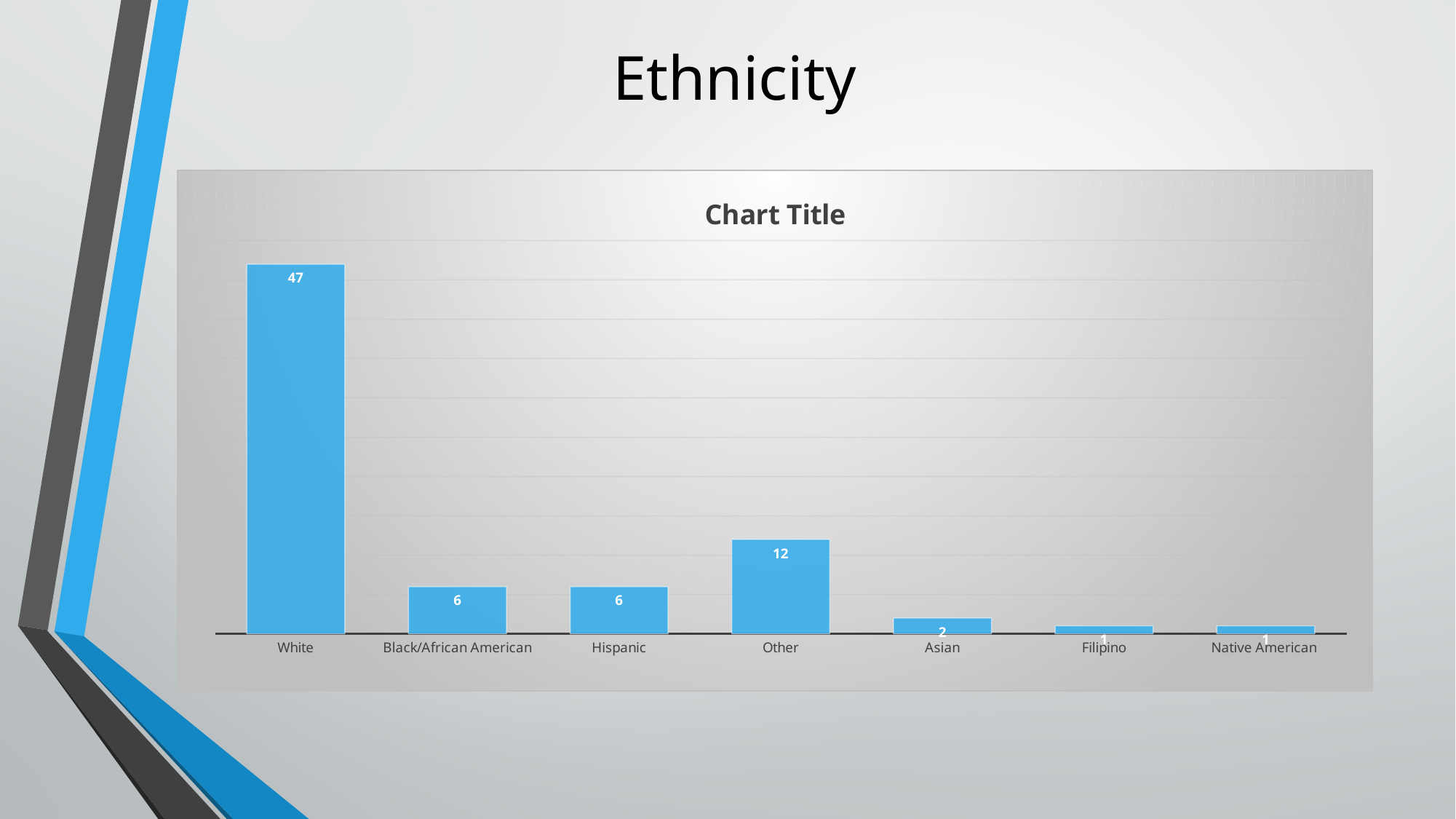
What is the difference between the values for Other and Black/African American? 6 What is the difference between the values for White and Other? 35 Which is larger, the value for Other or the value for Asian? Other What is the value for Other? 12 What kind of chart is shown? Bar chart What is the value for White? 47 What is the value for Asian? 2 Which category has the highest value? White What is the value for Hispanic? 6 What is the title shown above the chart? Chart Title Do the values for Black/African American and Hispanic differ? No, both are 6 How many categories are shown on the x axis? 7